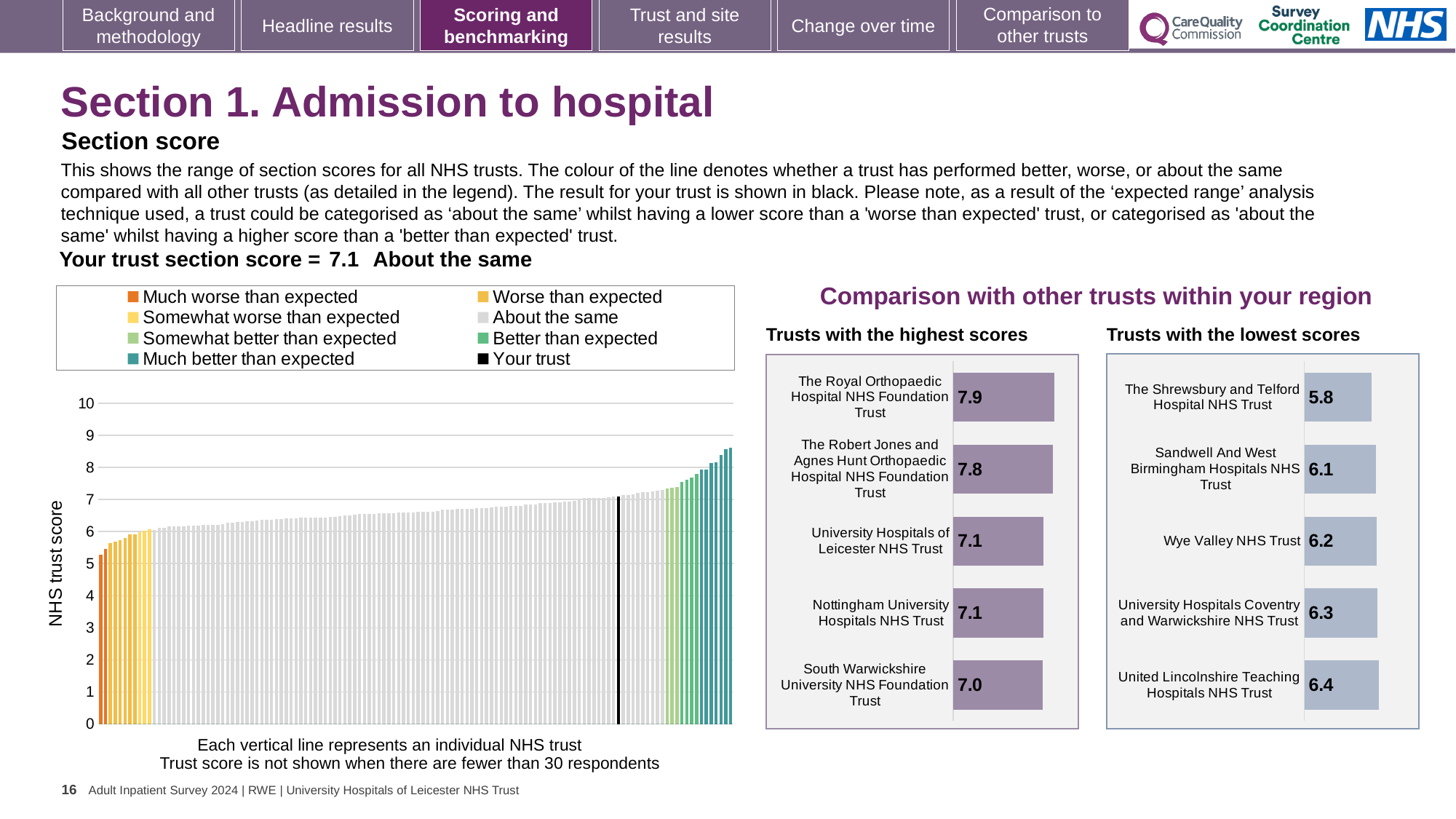
In the 'Trusts with the highest scores' chart, which trust has the lowest score shown? South Warwickshire University NHS Foundation Trust In the 'Trusts with the lowest scores' chart, which has the higher score: Sandwell And West Birmingham Hospitals NHS Trust or University Hospitals Coventry and Warwickshire NHS Trust? University Hospitals Coventry and Warwickshire NHS Trust In the 'Trusts with the highest scores' chart, what is the score for The Royal Orthopaedic Hospital NHS Foundation Trust? 7.9 How many entries does the legend of the left-hand NHS trust score chart list? 8 In the 'Trusts with the lowest scores' chart, what is the difference between the scores of United Lincolnshire Teaching Hospitals NHS Trust and The Shrewsbury and Telford Hospital NHS Trust? 0.6 In the 'Trusts with the highest scores' chart, what is the difference between the scores of The Royal Orthopaedic Hospital NHS Foundation Trust and South Warwickshire University NHS Foundation Trust? 0.9 In the left-hand NHS trust score chart, is the value of the tallest bar greater or less than 8? greater What kind of chart is the large chart on the left showing NHS trust scores? Bar chart How many trusts are listed in the 'Trusts with the highest scores' chart? 5 In the 'Trusts with the lowest scores' chart, what is the score for Wye Valley NHS Trust? 6.2 In the 'Trusts with the lowest scores' chart, which trust has the lowest score? The Shrewsbury and Telford Hospital NHS Trust In the left-hand NHS trust score chart, do the values rise or fall from left to right along the x axis? Rise